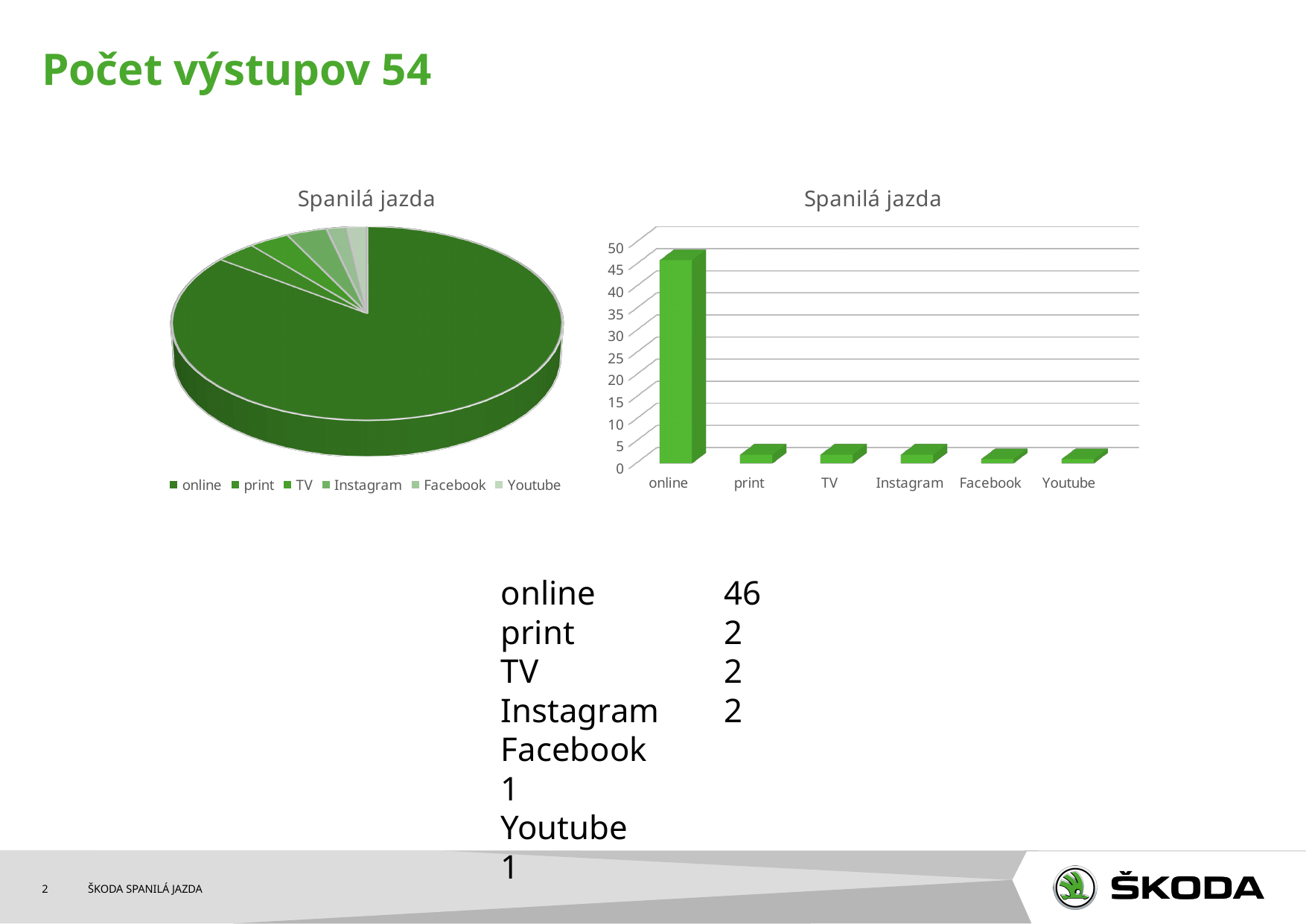
In the bar chart on the right, which is larger, the value for online or the value for TV? online In the bar chart on the right, how many categories are shown on the x axis? 6 According to the slide, what is the difference between the value for online and the value for print? 44 What is the title of the pie chart on the left? Spanilá jazda According to the slide, what is the value for online? 46 In the bar chart on the right, is the value for print greater or less than 5? less In the bar chart on the right, is the value for online greater or less than 40? greater In the pie chart on the left, how many entries does the legend list? 6 What kind of chart is the chart on the right of the slide? bar chart In the bar chart on the right, which category has the highest value? online According to the slide, what is the value for Facebook? 1 What kind of chart is the chart on the left of the slide? pie chart